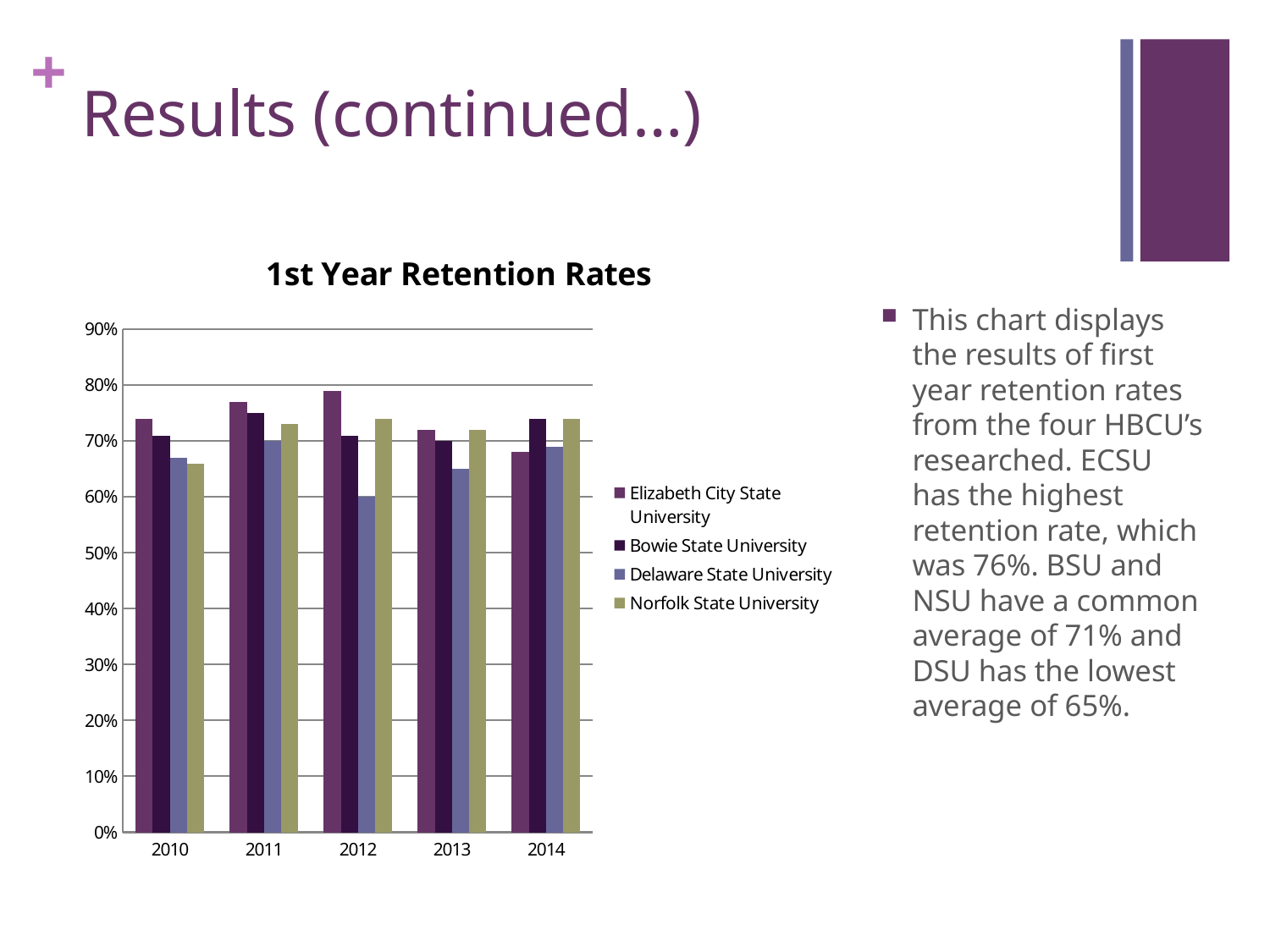
Is the value for Elizabeth City State University in 2012 greater or less than 70%? greater In 2014, which is larger: the value for Bowie State University or Elizabeth City State University? Bowie State University Do the values for Elizabeth City State University rise or fall from 2012 to 2014? fall What kind of chart is shown on the slide? bar chart Is the value for Delaware State University in 2013 greater or less than 70%? less In which year is the Elizabeth City State University bar the tallest? 2012 Is the value for Norfolk State University in 2010 greater or less than 70%? less Which university has the lowest retention rate in 2012? Delaware State University How many years are shown on the x axis? 5 Which university has the highest retention rate in 2012? Elizabeth City State University What is the title of the chart? 1st Year Retention Rates How many series does the legend list? 4